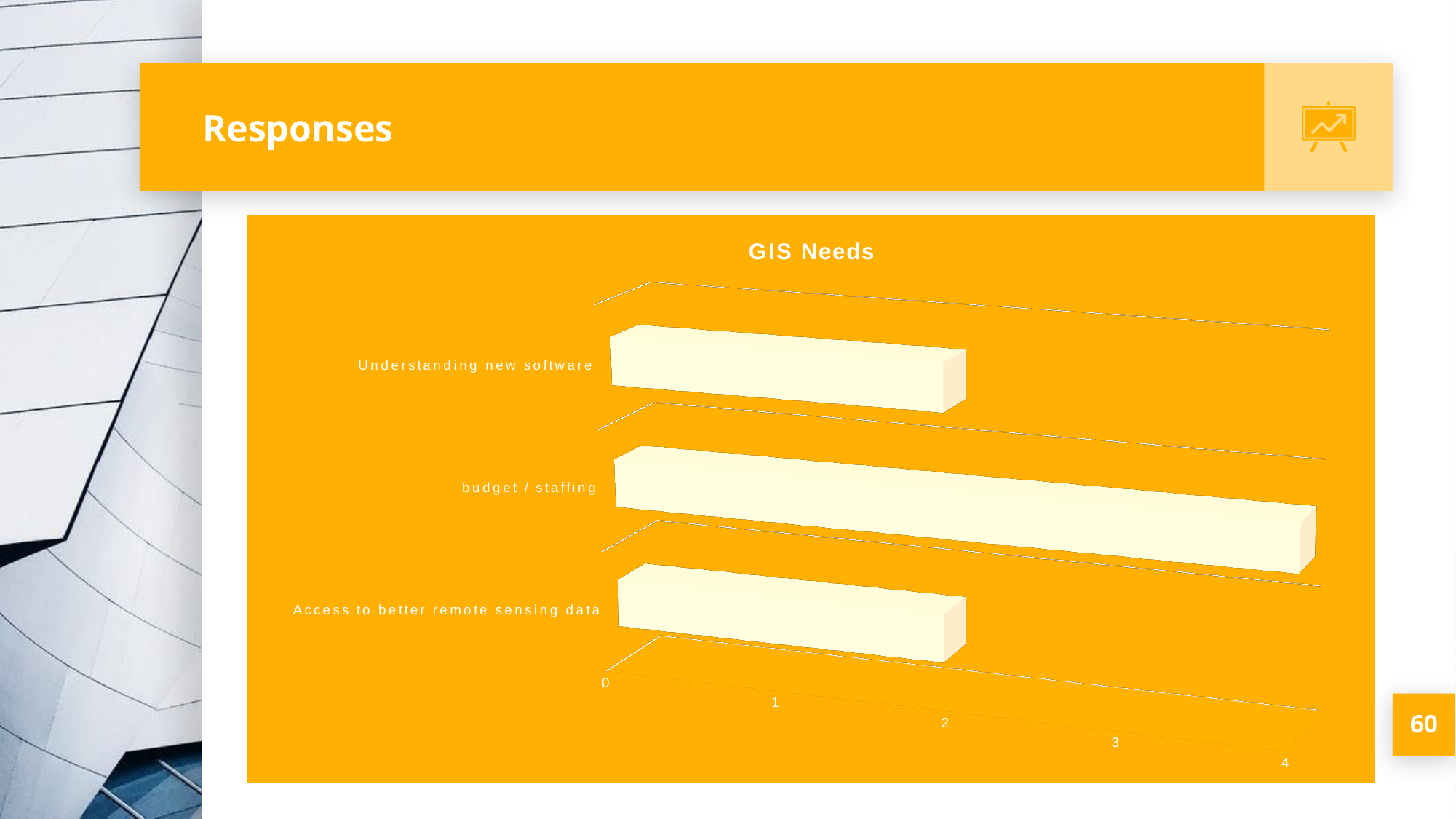
What type of chart is shown on the slide? bar chart Which is larger in the GIS Needs chart: budget / staffing or Understanding new software? budget / staffing How many categories are plotted in the GIS Needs chart? 3 Is the value for Access to better remote sensing data greater or less than 1? greater What is the title of the chart? GIS Needs What is the highest tick value shown on the value axis of the GIS Needs chart? 4 Which category has the highest value in the GIS Needs chart? budget / staffing Is the value for Understanding new software greater or less than 3? less Is the value for Understanding new software greater or less than 1? greater Which is larger in the GIS Needs chart: budget / staffing or Access to better remote sensing data? budget / staffing